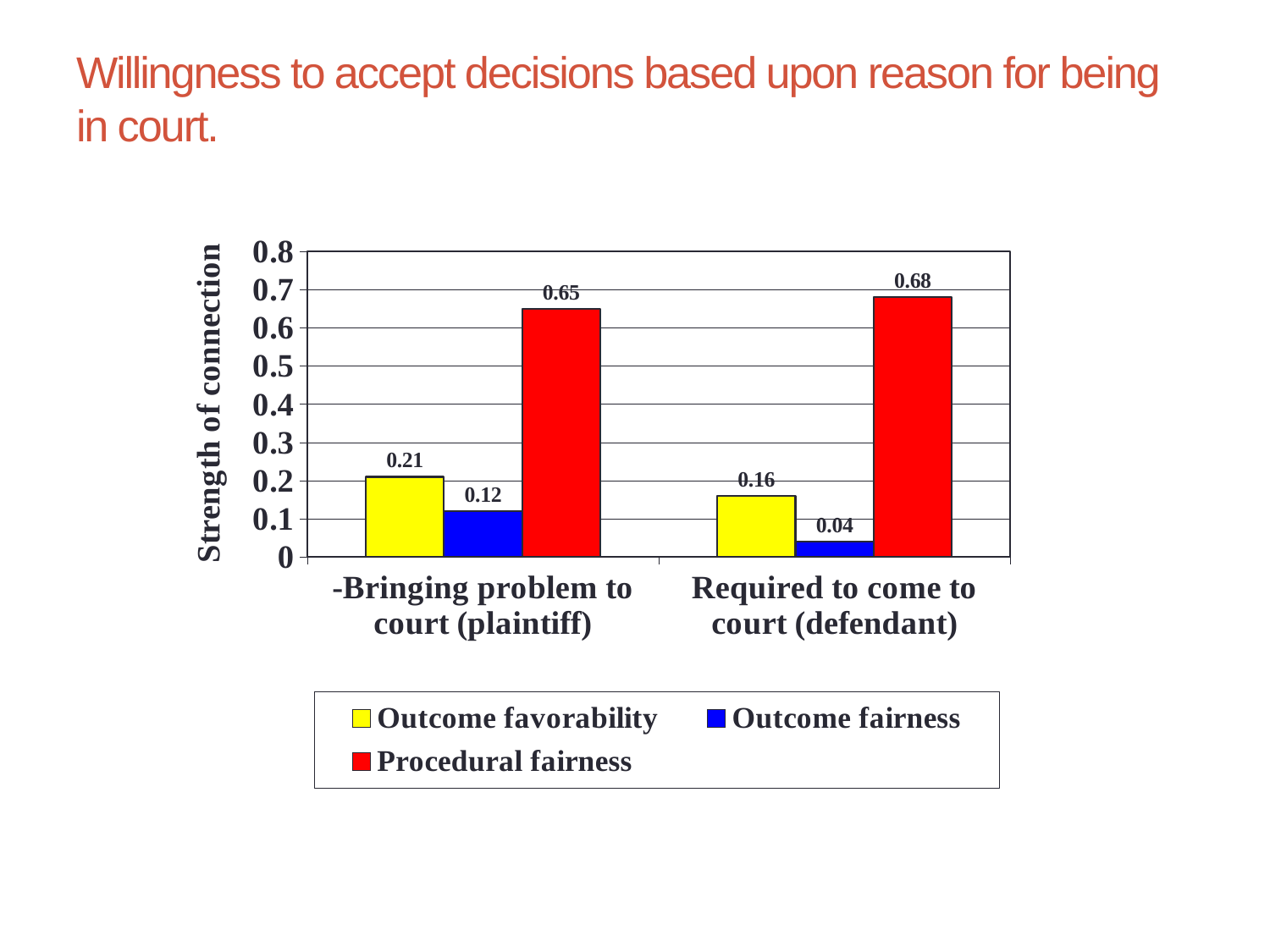
Which series has the highest value in the Required to come to court (defendant) category? Procedural fairness What is the value for Outcome fairness in the Required to come to court (defendant) category? 0.04 What is the value for Outcome favorability in the Bringing problem to court (plaintiff) category? 0.21 What kind of chart is shown on the slide? Bar chart Is the value for Procedural fairness in the defendant category greater or less than 0.6? greater What is the difference between Outcome favorability and Outcome fairness in the Required to come to court (defendant) category? 0.12 What is the value for Procedural fairness in the Bringing problem to court (plaintiff) category? 0.65 Which is larger: Outcome favorability for plaintiffs or Outcome favorability for defendants? Outcome favorability for plaintiffs How many series does the legend list? 3 What is the difference between the Procedural fairness values for the defendant and plaintiff categories? 0.03 How many categories are shown on the x axis? 2 Which series has the lowest value in the Bringing problem to court (plaintiff) category? Outcome fairness